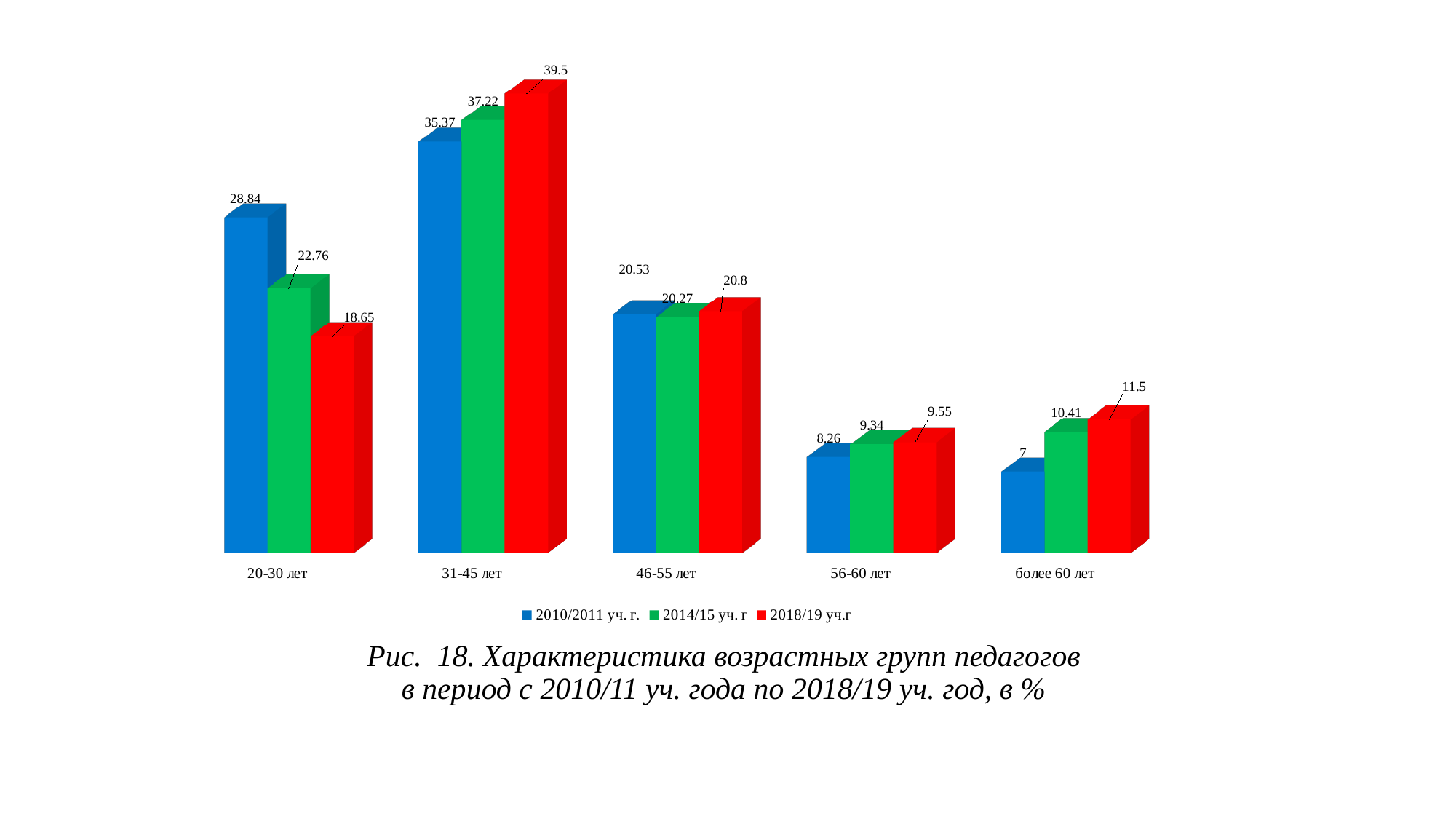
Which age group has the lowest value in the 2010/2011 уч. г. series? более 60 лет Which colour represents the 2014/15 уч. г series? Green How many series does the legend list? 3 What is the difference between the 2018/19 уч.г and 2010/2011 уч. г. values for the 31-45 лет group? 4.13 What is the value for the 31-45 лет group in the 2018/19 уч.г series? 39.5 Do the values for the 20-30 лет group rise or fall from 2010/2011 уч. г. to 2018/19 уч.г? Fall How many age groups are shown on the x axis? 5 What kind of chart is shown on the slide? Bar chart Which is larger for the 20-30 лет group: the 2014/15 уч. г value or the 2018/19 уч.г value? 2014/15 уч. г What is the value for the 20-30 лет group in the 2010/2011 уч. г. series? 28.84 Which age group has the highest value in the 2018/19 уч.г series? 31-45 лет What is the value for the более 60 лет group in the 2014/15 уч. г series? 10.41